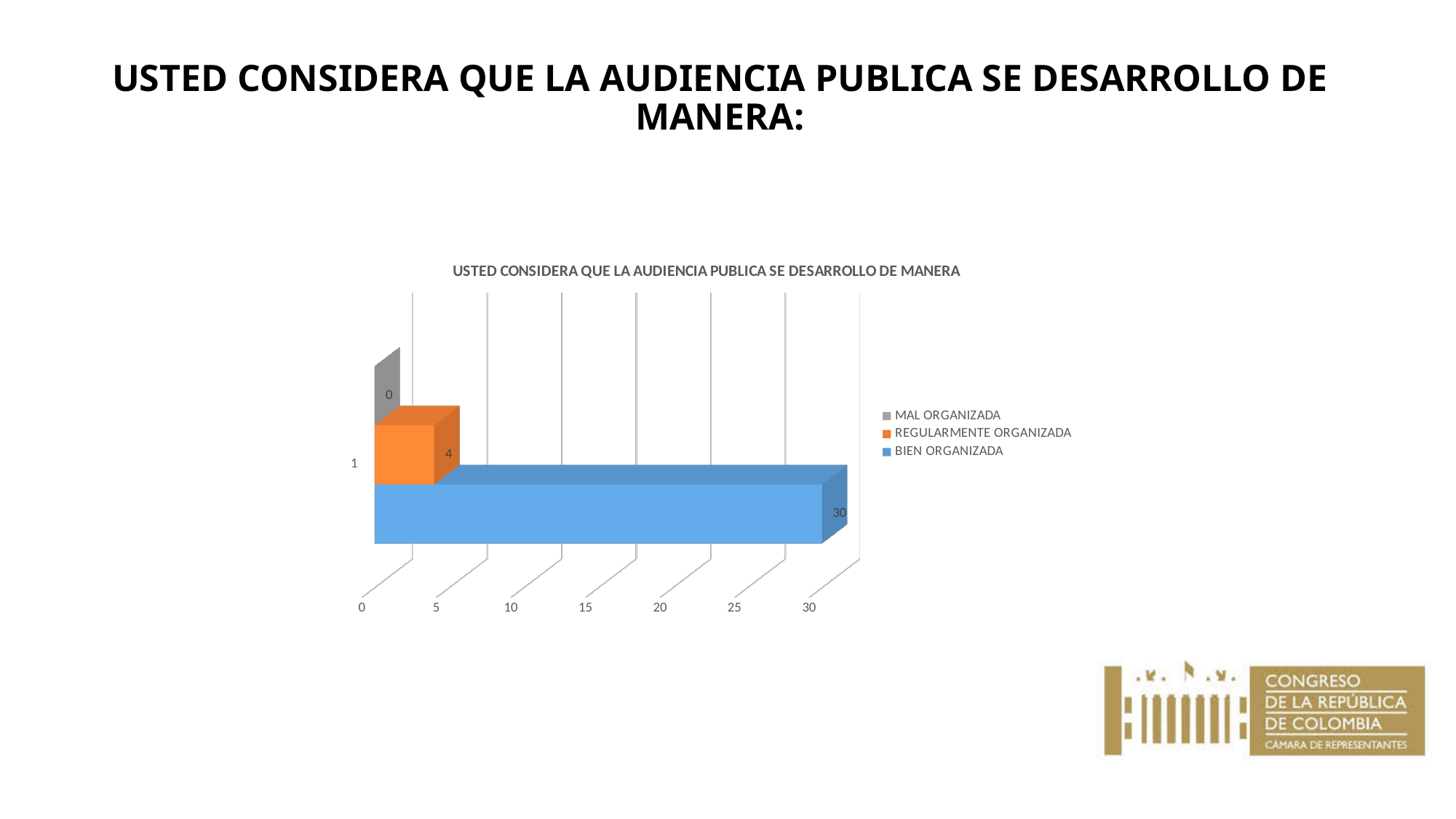
What is the value for BIEN ORGANIZADA? 30 Which is larger, the value for REGULARMENTE ORGANIZADA or the value for MAL ORGANIZADA? REGULARMENTE ORGANIZADA Which series has the highest value? BIEN ORGANIZADA What kind of chart is shown on the slide? bar chart Which series has the lowest value? MAL ORGANIZADA What is the value for MAL ORGANIZADA? 0 What is the value for REGULARMENTE ORGANIZADA? 4 What colour is the bar for BIEN ORGANIZADA? blue What is the total of the three values shown in the chart? 34 How many series does the legend list? 3 What is the difference between the values for BIEN ORGANIZADA and REGULARMENTE ORGANIZADA? 26 Is the value for BIEN ORGANIZADA greater or less than 25? greater